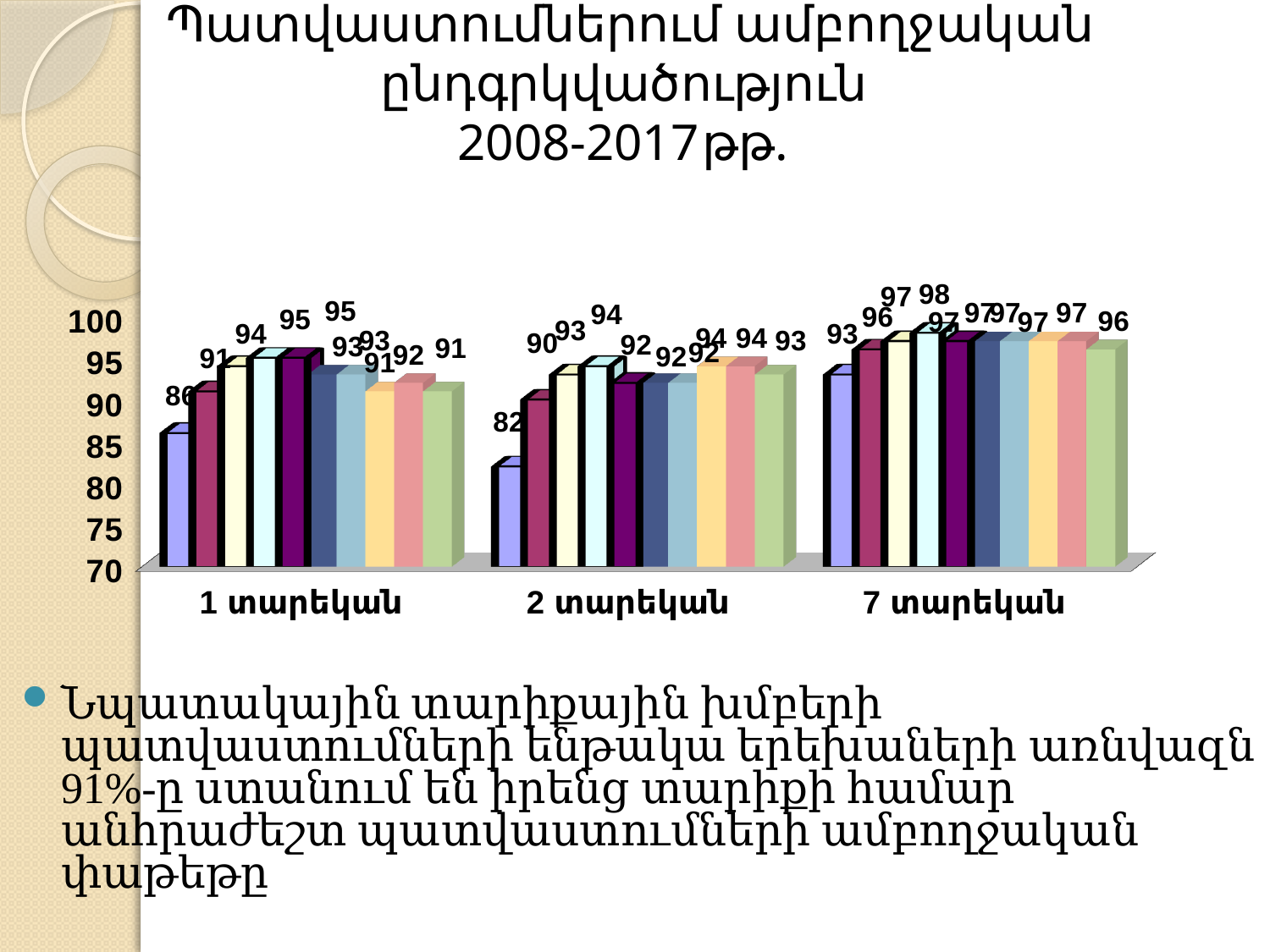
Which group has the larger first bar: "1 տարեկան" or "7 տարեկան"? 7 տարեկան What is the highest value labelled in the "7 տարեկան" group? 98 What is the value of the first (leftmost) bar in the "1 տարեկան" group? 86 How many bars are plotted for the category "1 տարեկան"? 10 Which years does the chart title say the data covers? 2008-2017 What kind of chart is shown on the slide? bar chart What is the difference between the first bar of "1 տարեկան" (86) and the first bar of "2 տարեկան" (82)? 4 What is the lowest value labelled anywhere on the chart? 82 How many categories are shown on the x axis of the chart? 3 What is the value of the first (leftmost) bar in the "2 տարեկան" group? 82 What is the lowest value shown on the vertical axis of the chart? 70 What is the value of the last (rightmost) bar in the "7 տարեկան" group? 96